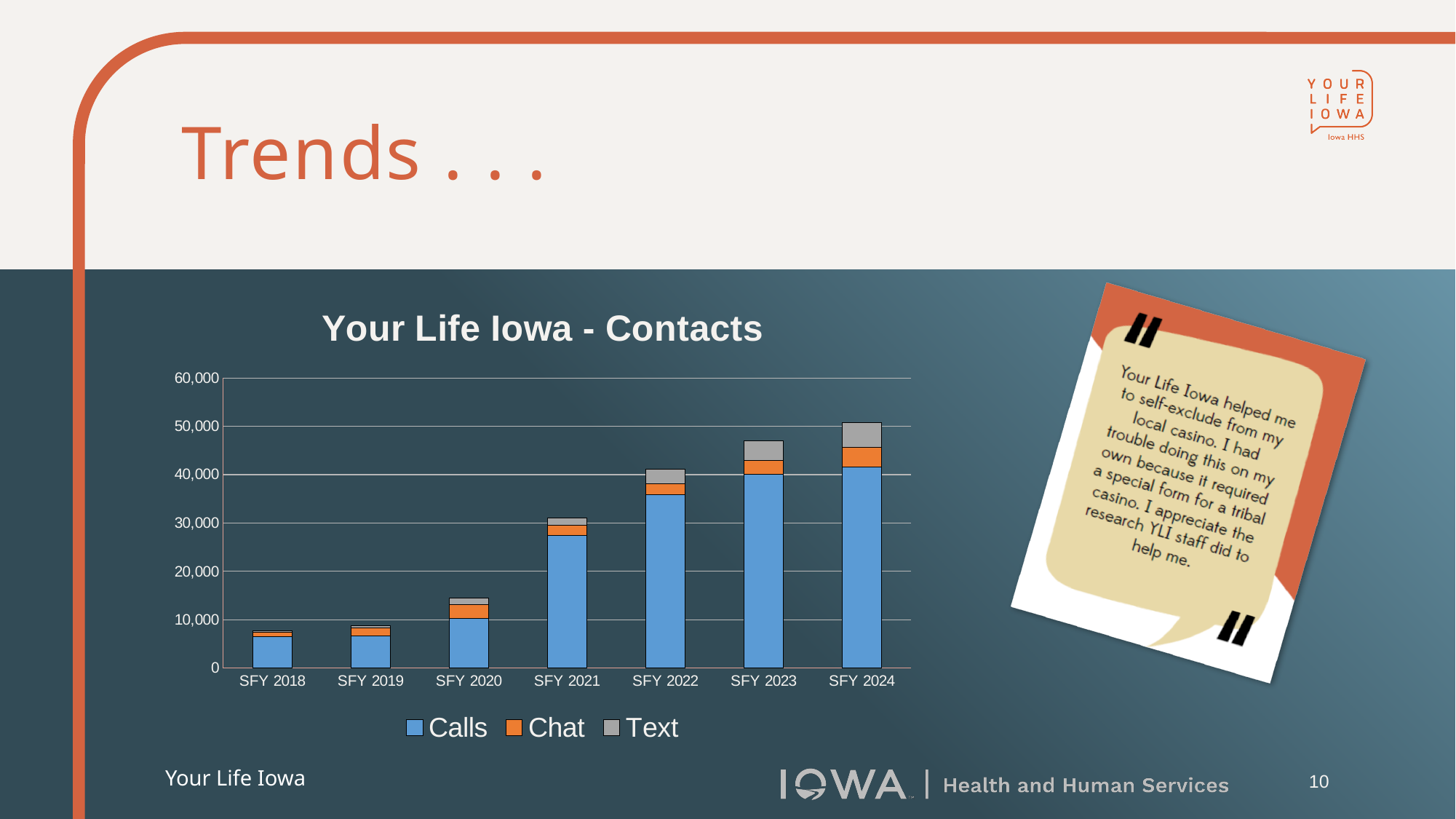
What is the title of the chart? Your Life Iowa - Contacts Is the total contacts value for SFY 2023 greater or less than 50,000? less Which fiscal year has the lowest total contacts? SFY 2018 Which fiscal year has the highest total contacts? SFY 2024 Is the total contacts value for SFY 2018 greater or less than 10,000? less Is the Calls value for SFY 2022 greater or less than 30,000? greater Which series is shown in orange in the chart legend? Chat Which is larger, the total contacts for SFY 2022 or for SFY 2021? SFY 2022 How many fiscal years are shown on the x axis of the chart? 7 What kind of chart is shown on the slide? Stacked bar chart Do total contacts generally rise or fall from SFY 2018 to SFY 2024? Rise How many series does the chart legend list? 3